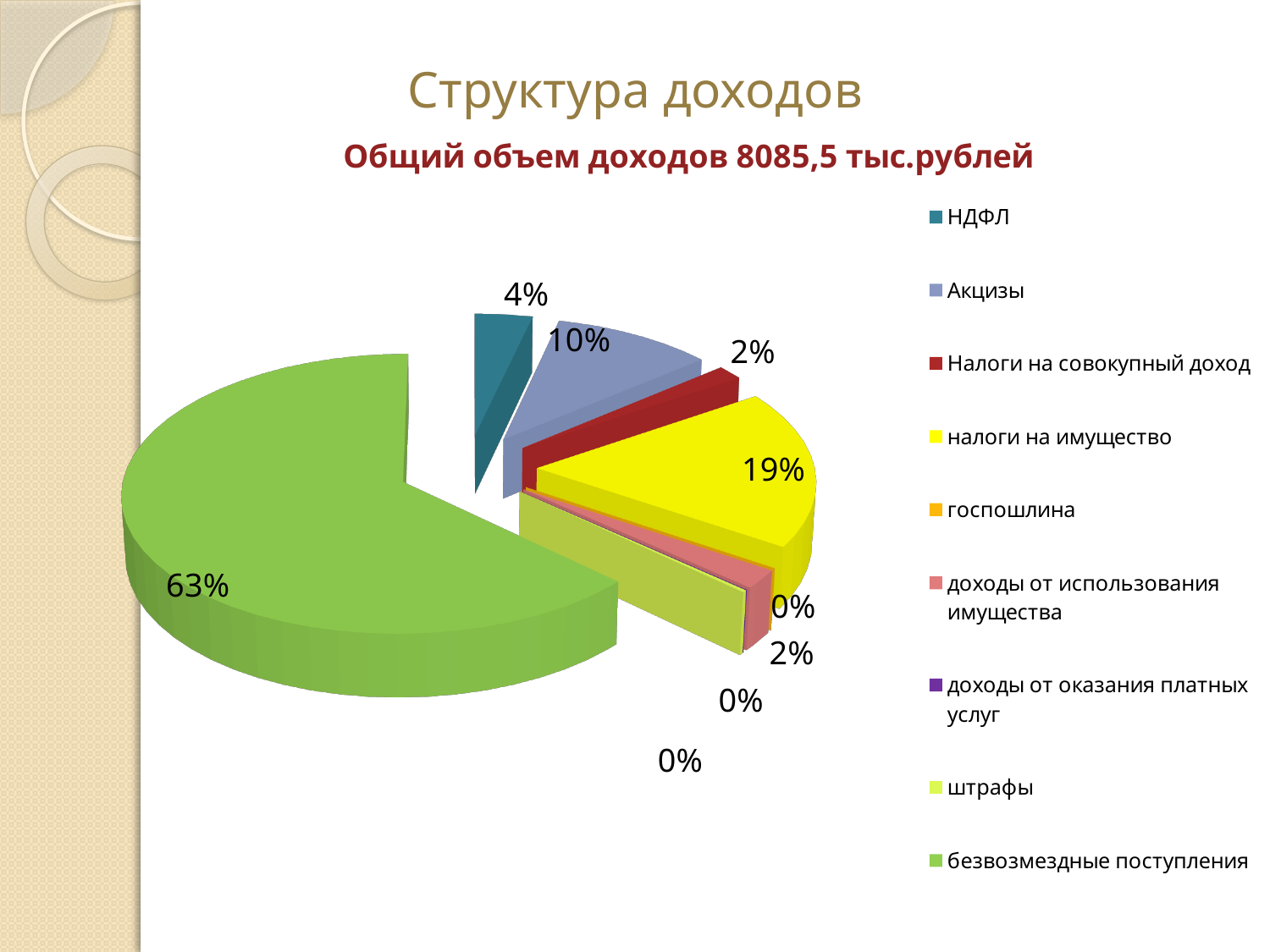
What kind of chart is shown on the slide? pie chart What share of revenue does налоги на имущество account for? 19% How many categories does the legend list? 9 What share of revenue does безвозмездные поступления account for? 63% Which is larger, the share for Акцизы or the share for НДФЛ? Акцизы What total revenue amount is stated above the chart? 8085,5 тыс.рублей What share of revenue does Акцизы account for? 10% What is the title of the chart? Общий объем доходов 8085,5 тыс.рублей What share of revenue does НДФЛ account for? 4% Which category has the largest share of the pie? безвозмездные поступления By how many percentage points does безвозмездные поступления exceed налоги на имущество? 44 What share of revenue does Налоги на совокупный доход account for? 2%